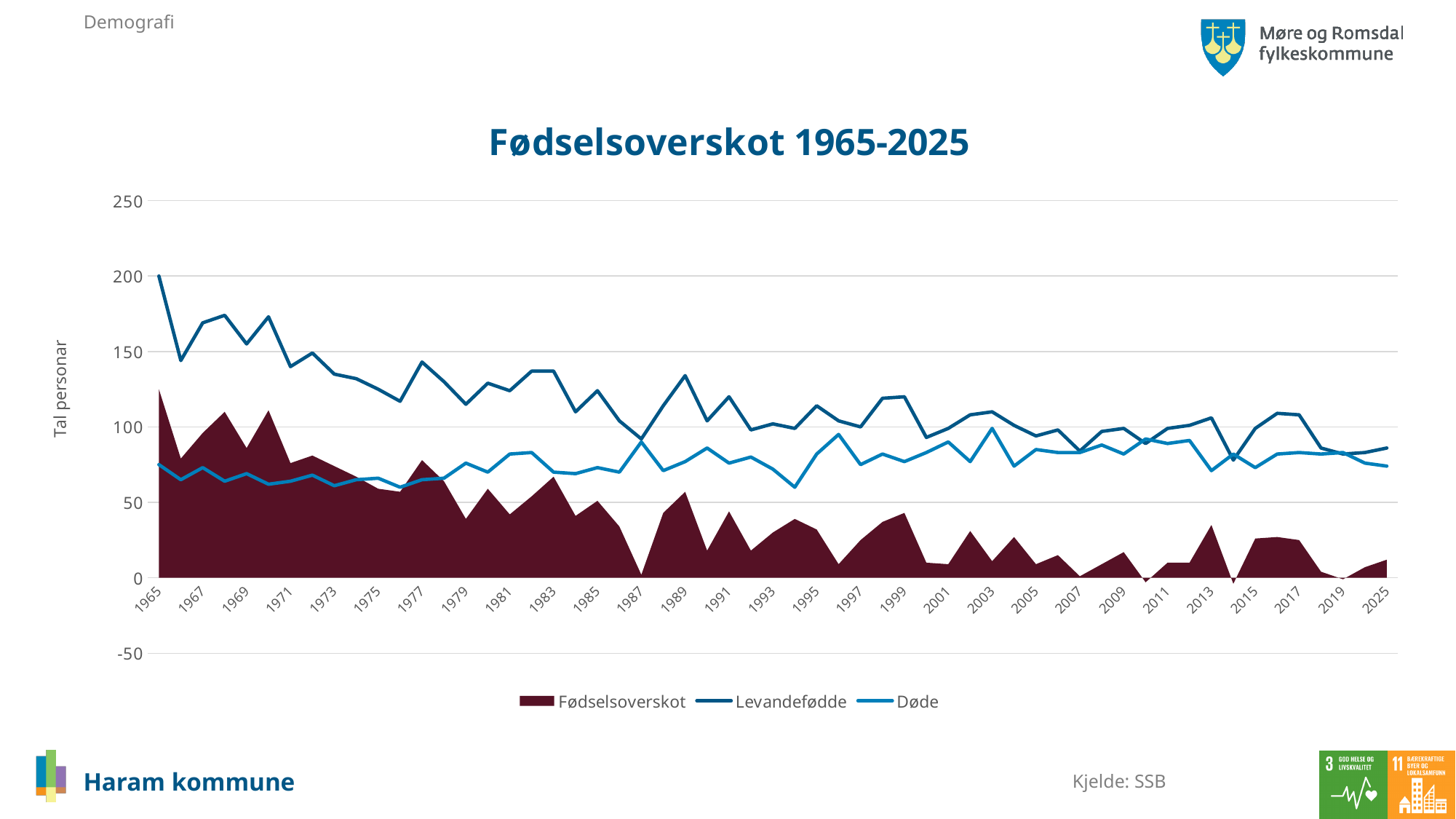
What kind of chart is shown on the slide? Combined area and line chart Is the value for Fødselsoverskot in 1965 greater or less than 100? greater Is the value for Fødselsoverskot in 1987 greater or less than 50? less Does the Levandefødde series generally rise or fall from 1965 to 2025? fall In which year is the Levandefødde series at its highest? 1965 What is the label on the vertical axis of the chart? Tal personar Is the value for Levandefødde in 1965 greater or less than 150? greater How many series does the chart legend list? 3 What is the title of the chart? Fødselsoverskot 1965-2025 Which is larger in 1965, Levandefødde or Døde? Levandefødde